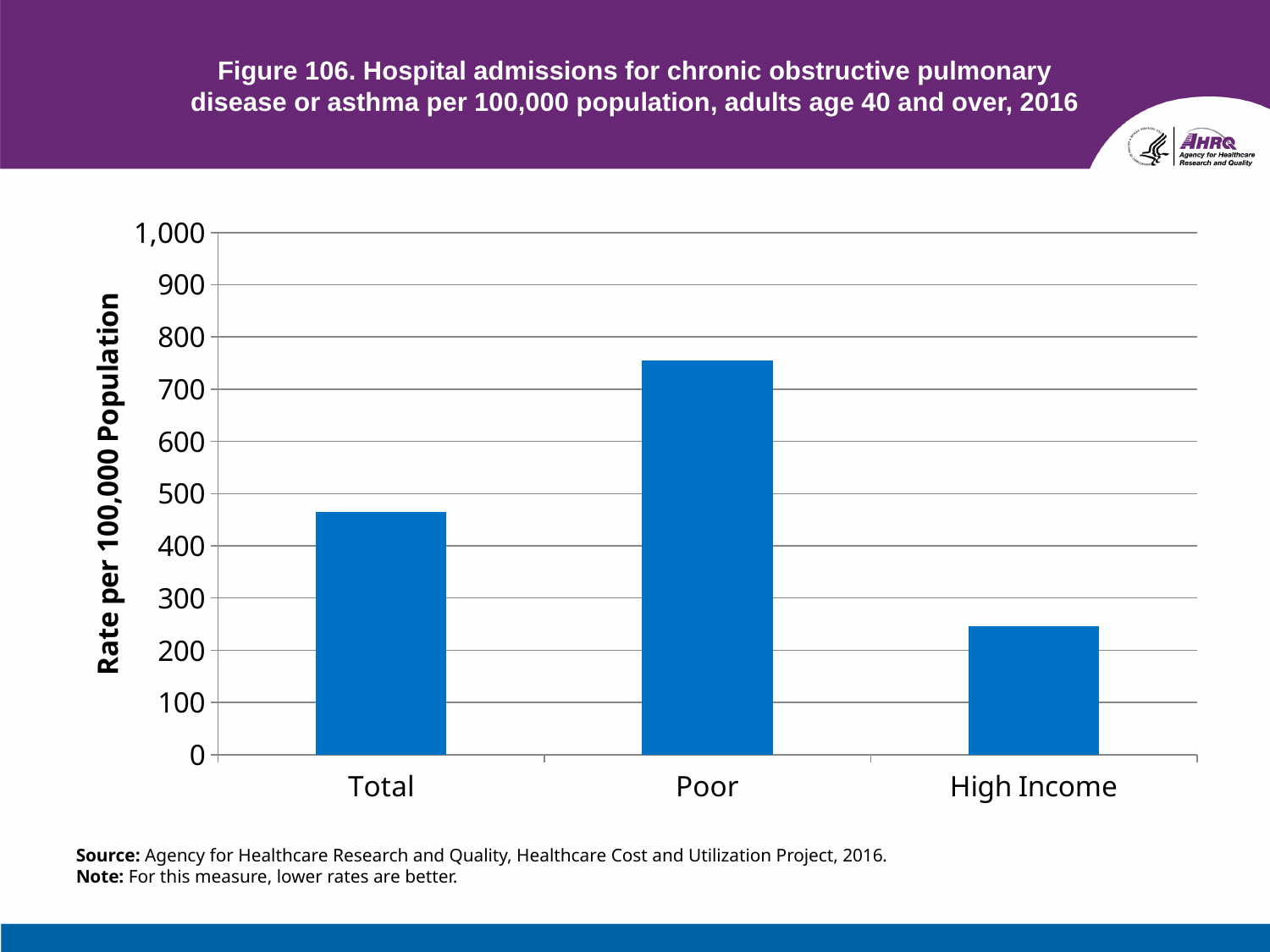
Which is larger, the value for Poor or the value for Total? Poor Which category has the lowest hospital admission rate? High Income Is the value for Total greater or less than 500? less What is the highest value shown on the y axis? 1,000 What is the label of the y axis? Rate per 100,000 Population Is the value for Total greater or less than 400? greater Which category has the highest hospital admission rate? Poor Which is larger, the value for Total or the value for High Income? Total How many categories are shown on the x axis? 3 What kind of chart is shown on the slide? bar chart Is the value for High Income greater or less than 300? less